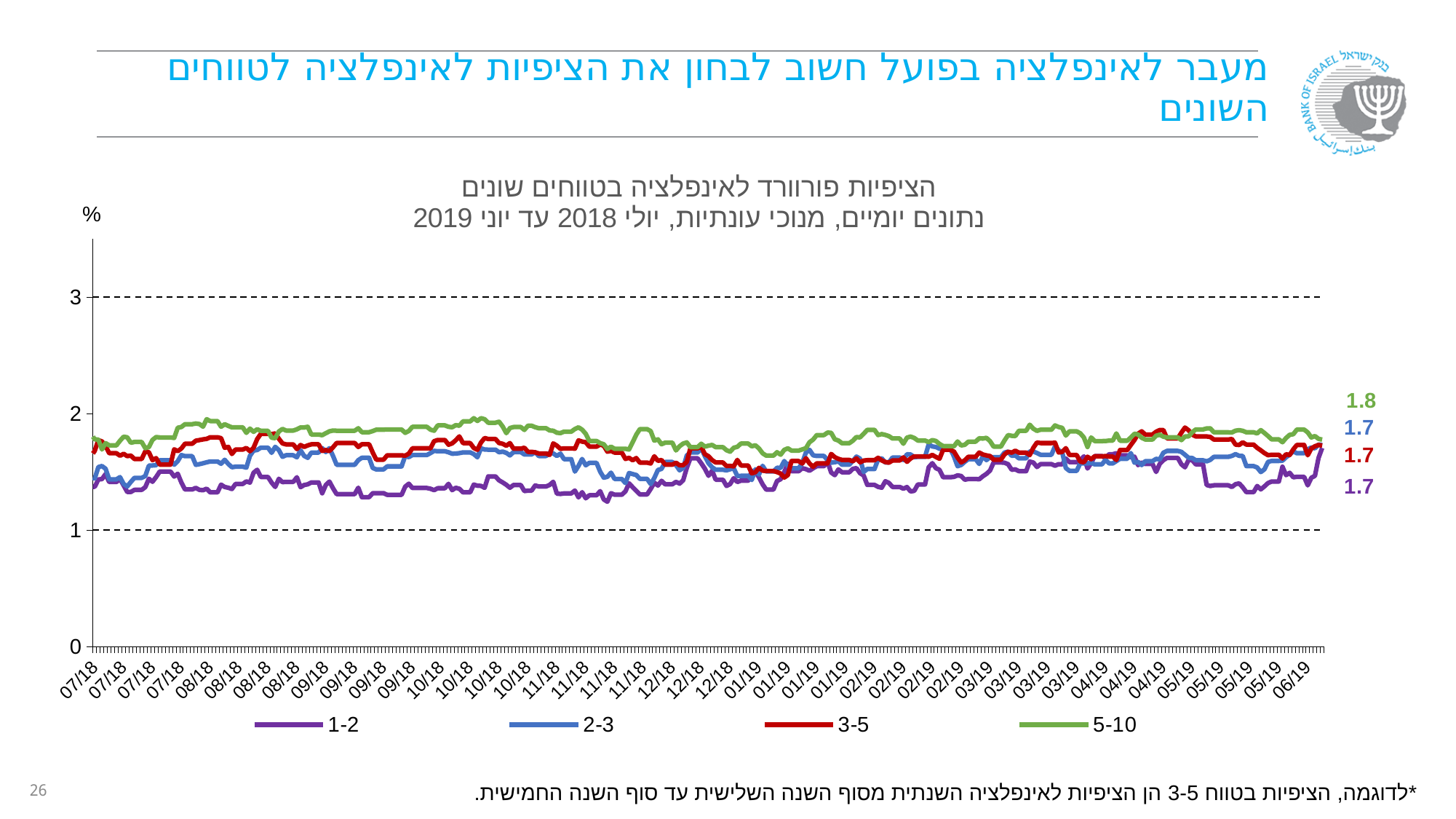
What is the final labelled value of the 1-2 series? 1.7 Does the 1-2 series end higher or lower than it starts in 07/18? higher What is the final labelled value of the 3-5 series? 1.7 What is the final labelled value of the 5-10 series? 1.8 What kind of chart is shown on the slide? line chart What is the difference between the final labelled values of the 5-10 and 3-5 series? 0.1 Is the value of the 5-10 series in 10/18 greater or less than 1? greater How many series does the legend list? 4 Which series has the highest labelled value at the end of the period? 5-10 At the end of the period, which is larger: the 5-10 series or the 1-2 series? 5-10 What colour is the line for the 5-10 series? green Is the value of the 1-2 series in 11/18 greater or less than 2? less